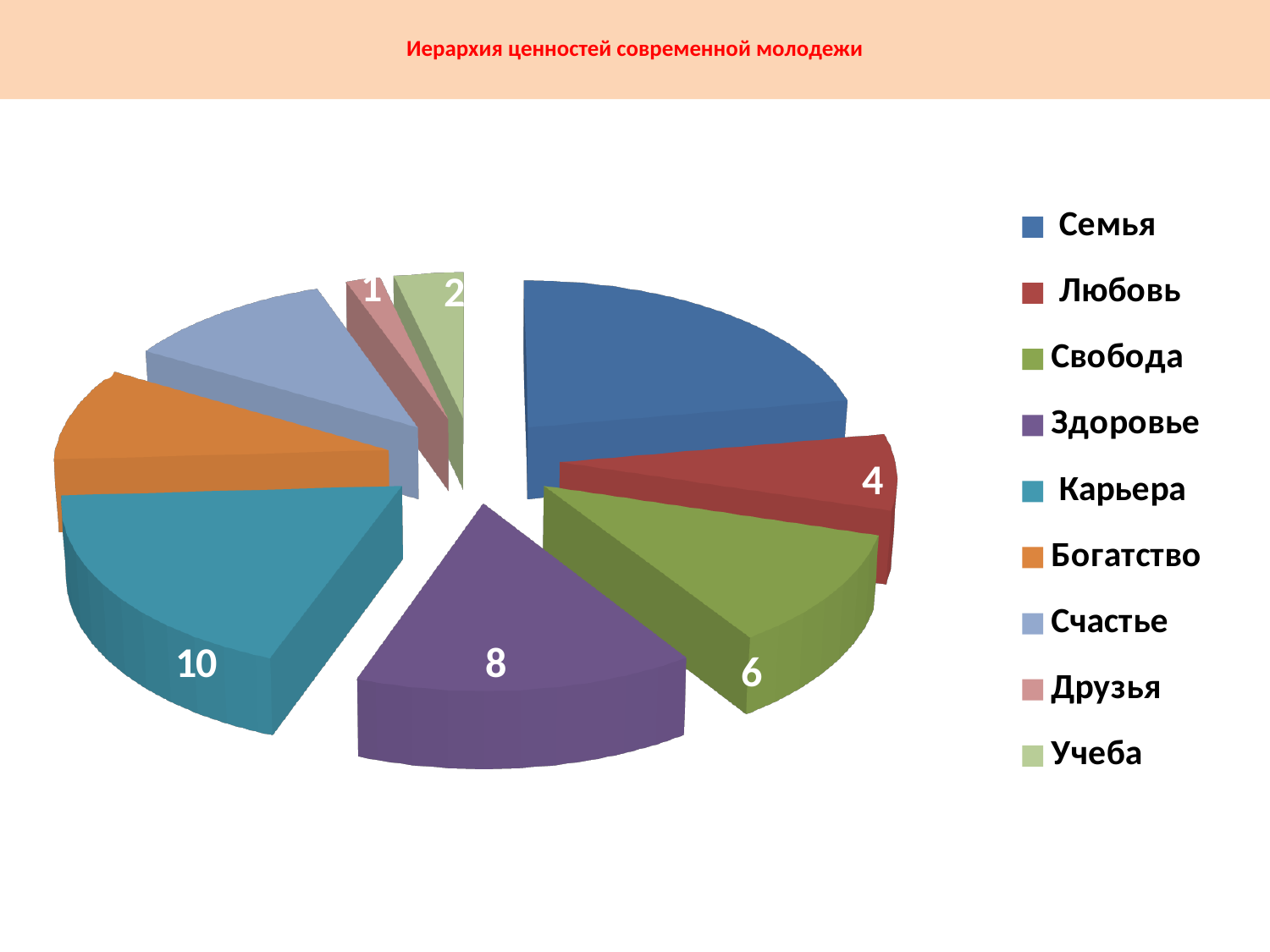
What kind of chart is shown on the slide? Pie chart What is the value for Друзья? 1 How many categories does the legend list? 9 Which is larger, the value for Здоровье or the value for Свобода? Здоровье What is the title of the slide? Иерархия ценностей современной молодежи What is the value for Любовь? 4 What is the value for Учеба? 2 Which category has the smallest slice? Друзья What is the value for Карьера? 10 What is the value for Здоровье? 8 What is the difference between the values for Карьера and Здоровье? 2 What is the value for Свобода? 6